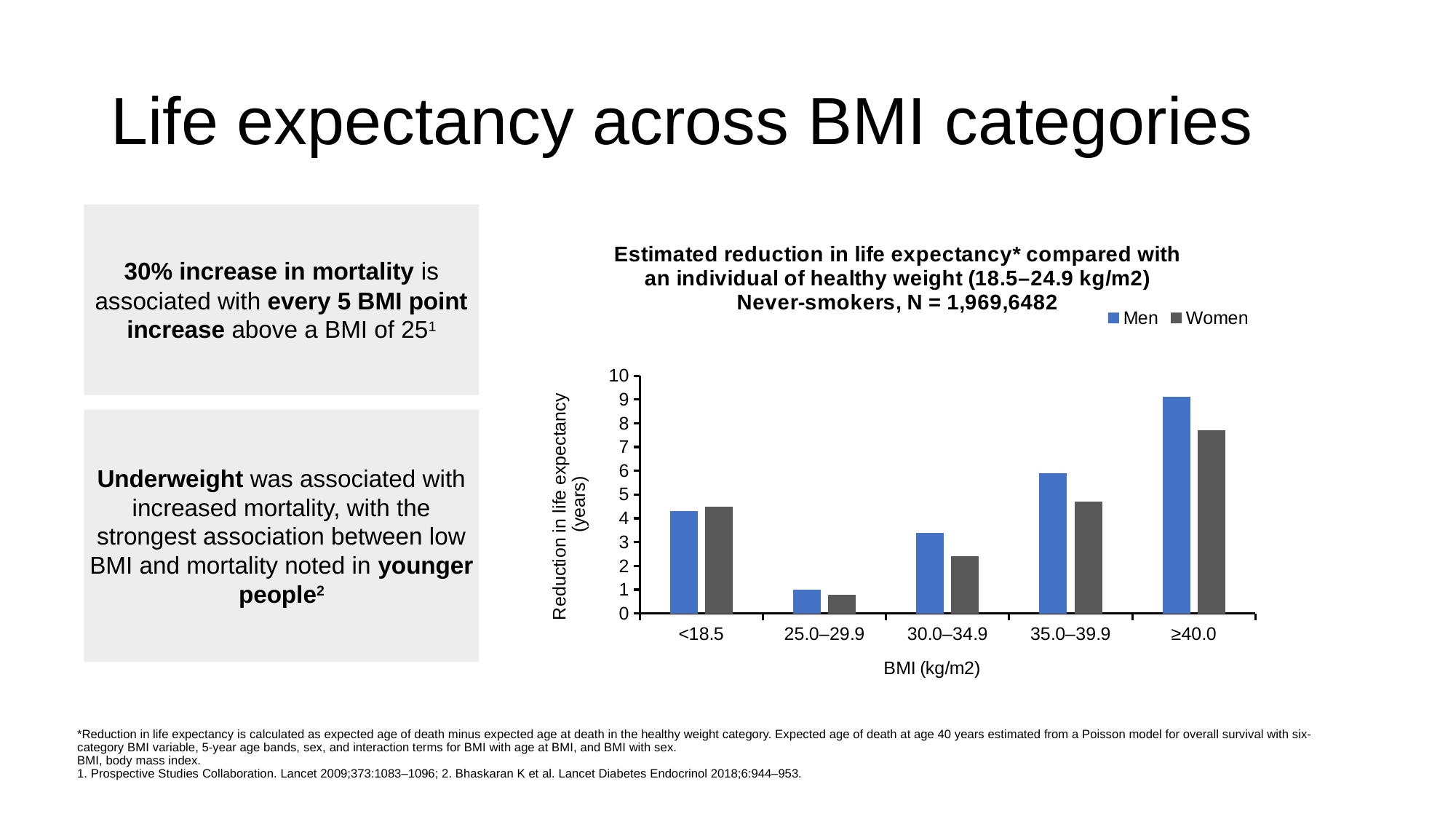
Which BMI category has the lowest reduction in life expectancy for Men? 25.0–29.9 What kind of chart is shown on the slide? Bar chart Which BMI category has the highest reduction in life expectancy for Women? ≥40.0 How many series does the chart legend list? 2 Do the Men values rise or fall across the BMI categories from 25.0–29.9 to ≥40.0? Rise Is the value for Men in the ≥40.0 BMI category greater or less than 8? greater What are the two entries in the chart legend? Men and Women In the 30.0–34.9 BMI category, which series has the larger reduction in life expectancy, Men or Women? Men How many BMI categories are shown on the x axis of the chart? 5 Is the value for Women in the ≥40.0 BMI category greater or less than 7? greater In the 35.0–39.9 BMI category, which series has the larger reduction in life expectancy, Men or Women? Men Which BMI category has the highest reduction in life expectancy for Men? ≥40.0